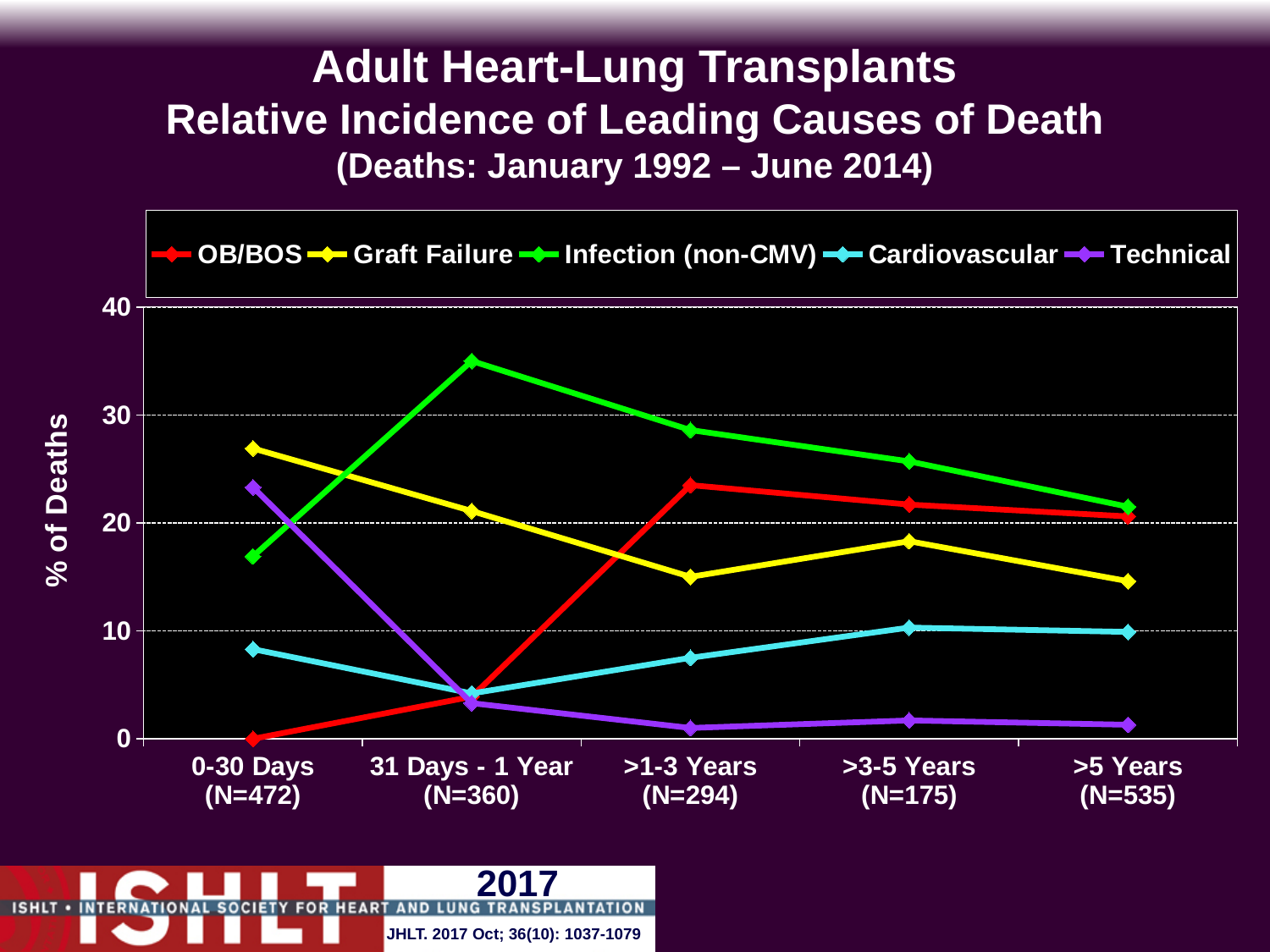
What is the label on the y axis? % of Deaths At >5 Years, which is larger: Infection (non-CMV) or Graft Failure? Infection (non-CMV) Is the value for Infection (non-CMV) at 31 Days - 1 Year greater or less than 30? greater Which cause of death has the lowest % of deaths in the >1-3 Years period? Technical What kind of chart is shown on the slide? line chart Does the Technical line rise or fall from 0-30 Days to 31 Days - 1 Year? fall How many time-period categories are shown on the x axis? 5 Which cause of death has the highest % of deaths in the 0-30 Days period? Graft Failure Which cause of death has the highest % of deaths in the 31 Days - 1 Year period? Infection (non-CMV) What is the value for OB/BOS in the 0-30 Days period? 0 Is the value for Cardiovascular at 0-30 Days greater or less than 10? less How many series does the legend list? 5